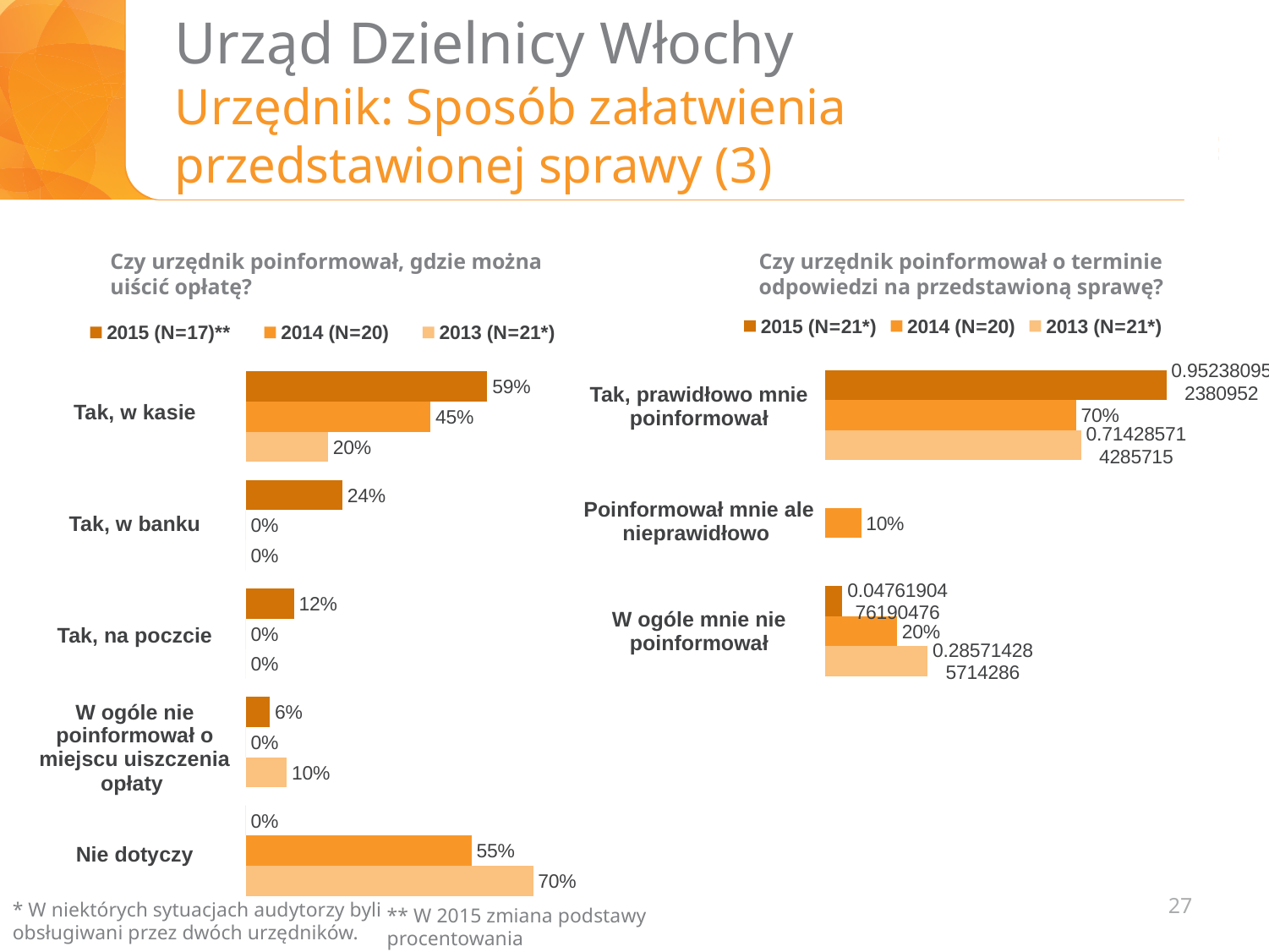
In the right chart (Czy urzędnik poinformował o terminie odpowiedzi na przedstawioną sprawę?), which series has the highest value for 'Tak, prawidłowo mnie poinformował'? 2015 (N=21*) In the left chart (Czy urzędnik poinformował, gdzie można uiścić opłatę?), what is the value for 'Nie dotyczy' in 2013? 70% In the left chart (Czy urzędnik poinformował, gdzie można uiścić opłatę?), what is the difference between the 2015 and 2013 values for 'Tak, w kasie'? 39 percentage points How many series does the legend of the right chart (Czy urzędnik poinformował o terminie odpowiedzi na przedstawioną sprawę?) list? 3 In the left chart (Czy urzędnik poinformował, gdzie można uiścić opłatę?), which category has the highest value for 2014? Nie dotyczy In the left chart (Czy urzędnik poinformował, gdzie można uiścić opłatę?), what is the value for 'Tak, w kasie' in 2015? 59% In the left chart (Czy urzędnik poinformował, gdzie można uiścić opłatę?), what is the value for 'Tak, w banku' in 2014? 0% In the left chart (Czy urzędnik poinformował, gdzie można uiścić opłatę?), which is larger for 'Nie dotyczy': the 2014 value or the 2013 value? 2013 In the right chart (Czy urzędnik poinformował o terminie odpowiedzi na przedstawioną sprawę?), what is the 2014 value for 'Tak, prawidłowo mnie poinformował'? 70% How many categories are shown in the left chart (Czy urzędnik poinformował, gdzie można uiścić opłatę?)? 5 What type of chart is the right chart (Czy urzędnik poinformował o terminie odpowiedzi na przedstawioną sprawę?)? Bar chart In the right chart (Czy urzędnik poinformował o terminie odpowiedzi na przedstawioną sprawę?), what is the 2014 value for 'W ogóle mnie nie poinformował'? 20%